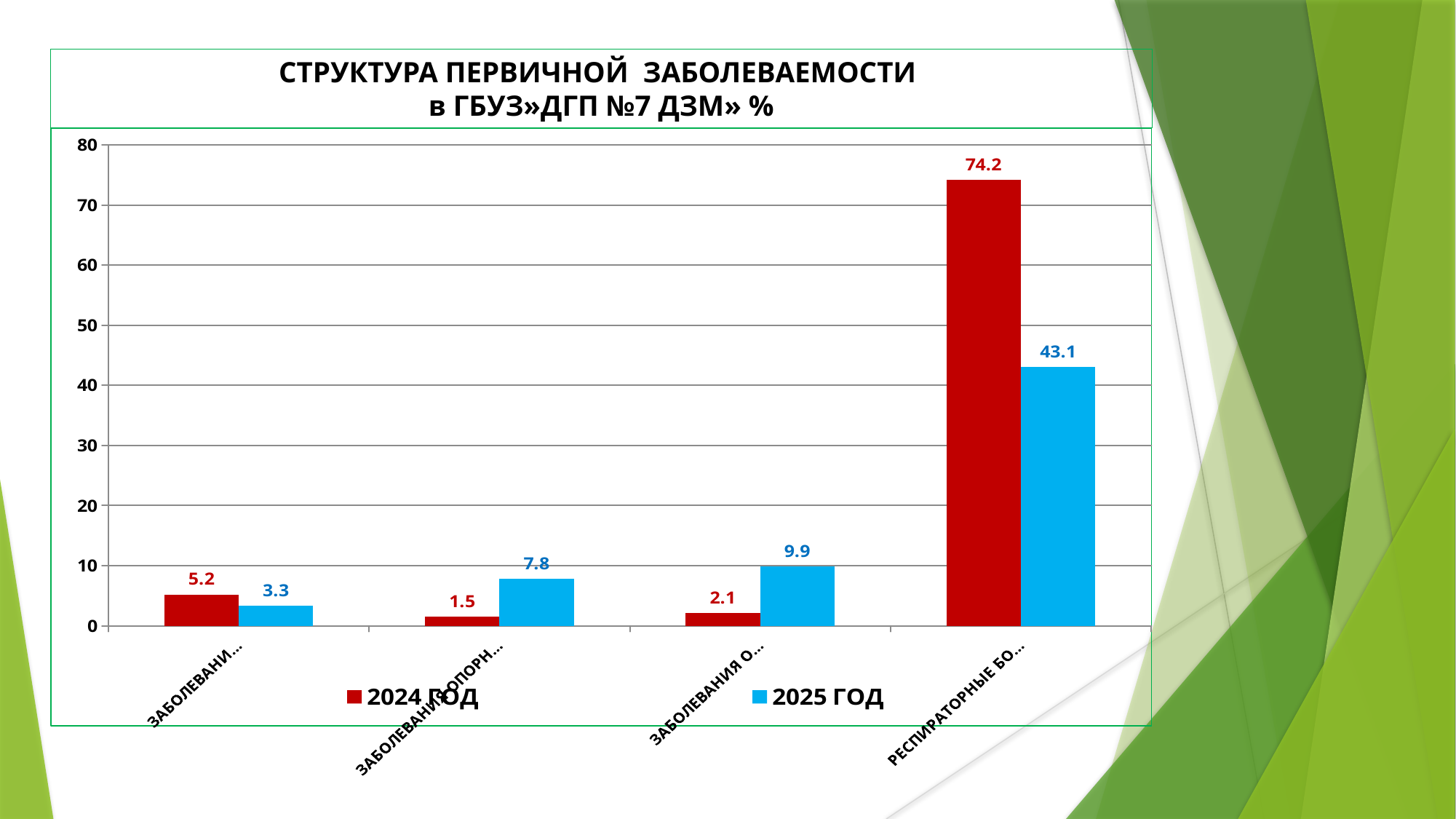
Which category has the highest 2024 ГОД value? РЕСПИРАТОРНЫЕ БО... What kind of chart is shown on the slide? bar chart What is the difference between the 2025 ГОД and 2024 ГОД values for the third category from the left? 7.8 What is the 2025 ГОД value for the РЕСПИРАТОРНЫЕ БО... category? 43.1 How many categories are shown on the x axis? 4 Is the 2025 ГОД value for the РЕСПИРАТОРНЫЕ БО... category greater or less than 40? greater What is the 2024 ГОД value for the РЕСПИРАТОРНЫЕ БО... category? 74.2 What is the difference between the 2024 ГОД and 2025 ГОД values for the РЕСПИРАТОРНЫЕ БО... category? 31.1 For the first category on the left, which series has the larger value, 2024 ГОД or 2025 ГОД? 2024 ГОД What is the 2025 ГОД value for the third category from the left? 9.9 How many series does the legend list? 2 What is the lowest 2024 ГОД value shown on the chart? 1.5